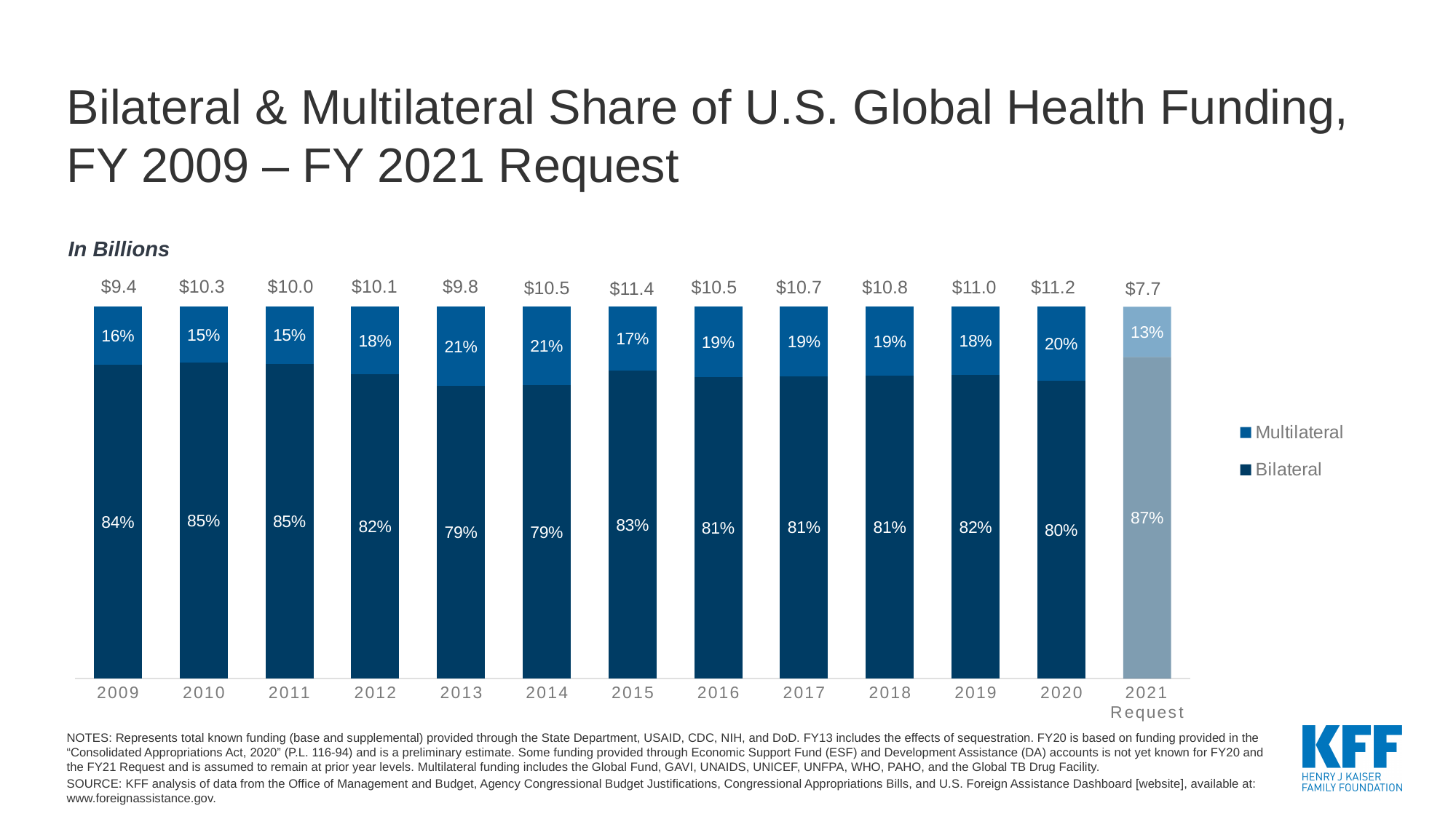
Which is larger, the Multilateral share in 2013 or the Multilateral share in 2017? 2013 How many series does the legend list? 2 What are the two series listed in the legend? Multilateral and Bilateral What is the Multilateral share of U.S. global health funding in FY 2020? 20% Which year has the lowest Multilateral share? 2021 Request What total funding amount (in billions) is shown above the bar for the 2021 Request? $7.7 What kind of chart is shown on the slide? Stacked bar chart What is the Bilateral share of U.S. global health funding in FY 2013? 79% What total funding amount (in billions) is shown above the bar for 2015? $11.4 What is the difference between the Bilateral share in 2011 and the Bilateral share in 2014? 6 percentage points How many years (categories) are shown on the x axis? 13 Which year has the highest total funding amount shown above its bar? 2015